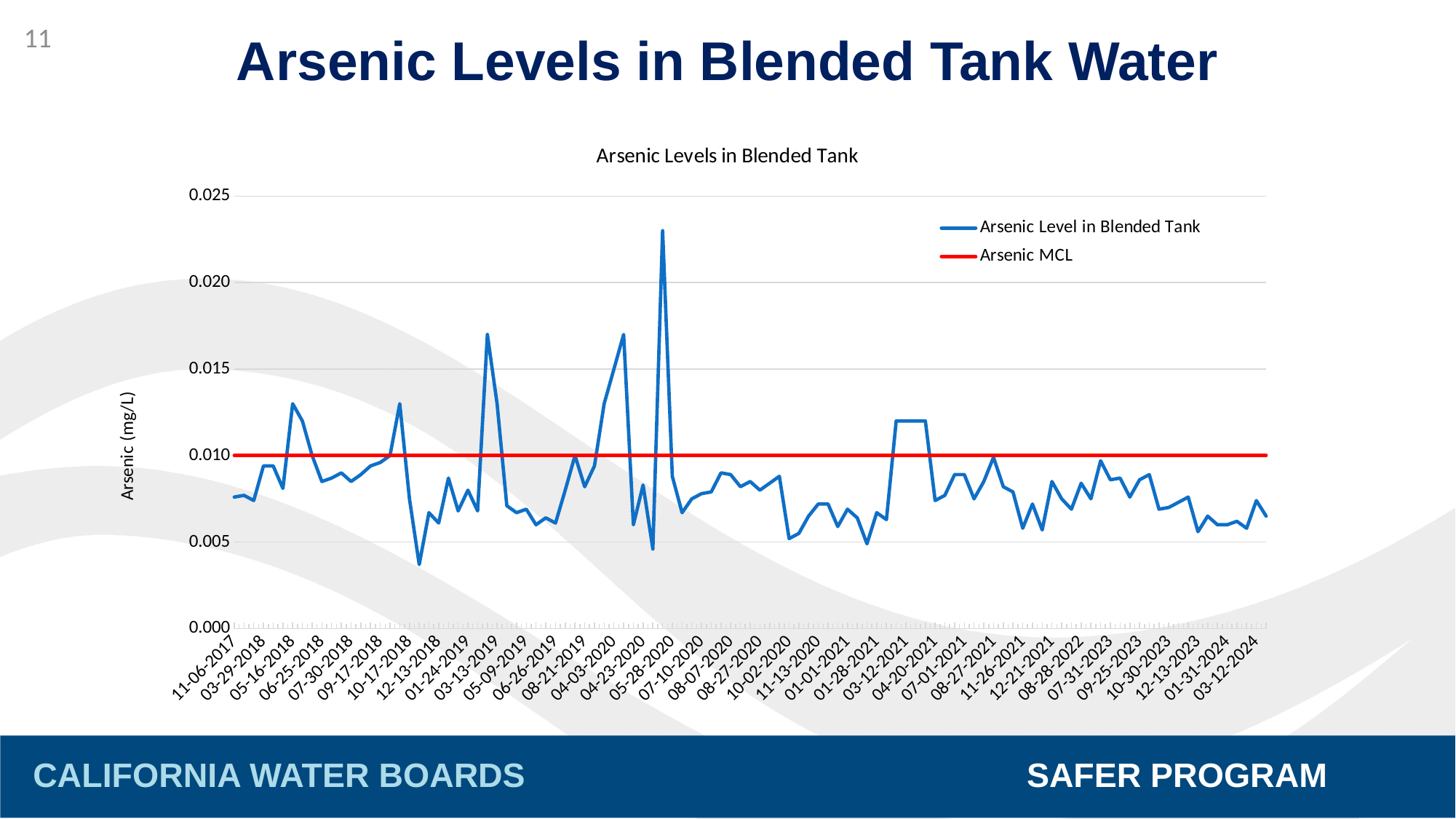
What kind of chart is shown on the slide? Line chart Is the lowest value of the Arsenic Level in Blended Tank series greater or less than 0.005? less Is the highest value of the Arsenic Level in Blended Tank series greater or less than 0.020? greater Is the Arsenic Level in Blended Tank value at 03-12-2024 greater or less than 0.010? less What is the label on the vertical axis of the chart? Arsenic (mg/L) What is the highest tick value shown on the vertical axis? 0.025 How many series does the chart legend list? 2 At what value does the Arsenic MCL line sit on the vertical axis? 0.010 Does the Arsenic MCL line rise, fall, or stay flat across the x axis? Stays flat What are the two series named in the chart legend? Arsenic Level in Blended Tank and Arsenic MCL At the last date on the x axis, 03-12-2024, which is higher: the Arsenic MCL line or the Arsenic Level in Blended Tank line? Arsenic MCL